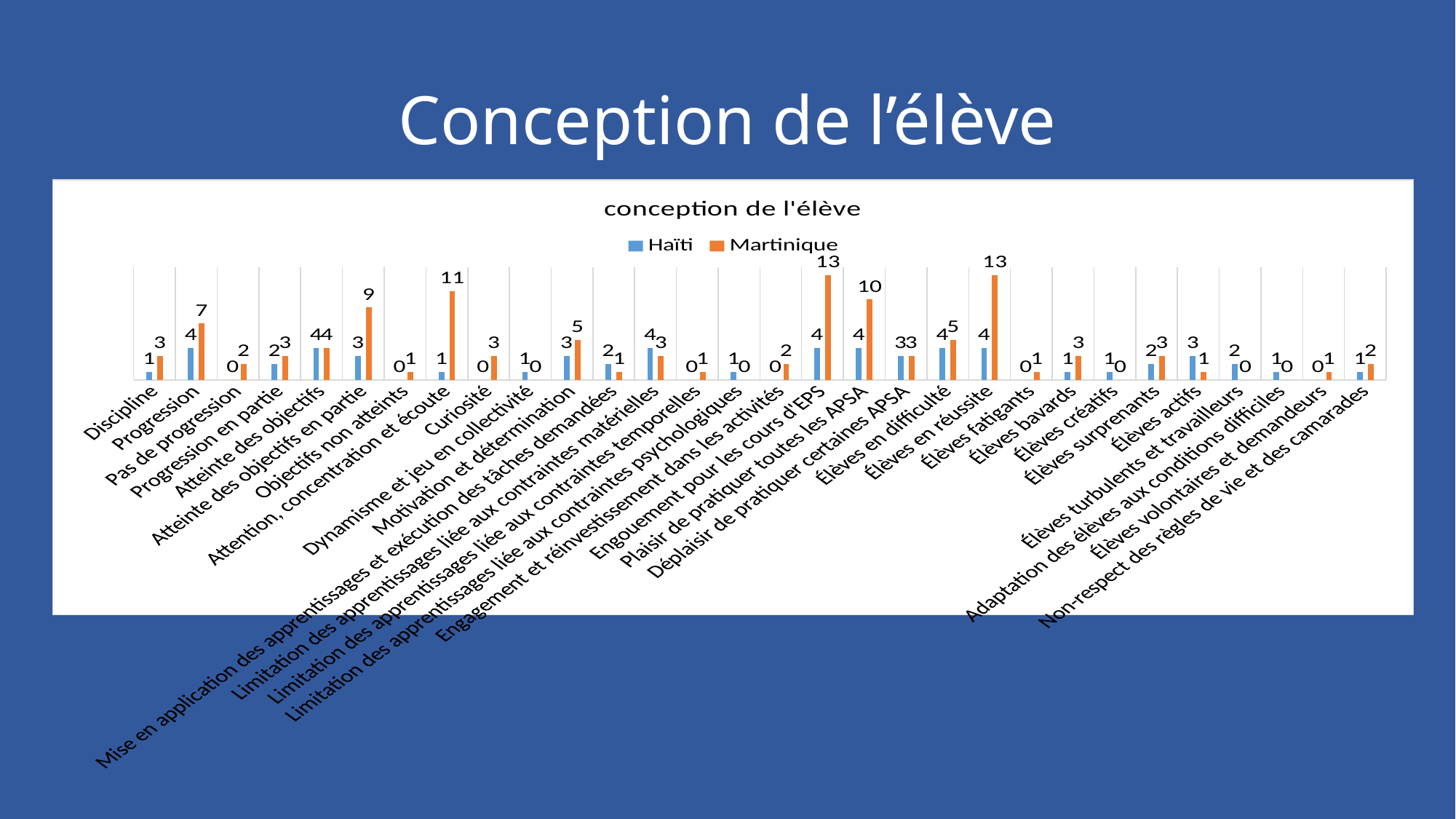
What is the Haïti value for "Progression"? 4 What kind of chart is shown on the slide? Bar chart What is the difference between the Martinique and Haïti values for "Engouement pour les cours d'EPS"? 9 What is the Haïti value for "Élèves actifs"? 3 For "Élèves actifs", which series has the larger value, Haïti or Martinique? Haïti What is the Martinique value for "Plaisir de pratiquer toutes les APSA"? 10 What is the Martinique value for "Attention, concentration et écoute"? 11 What is the difference between the Martinique and Haïti values for "Progression"? 3 For "Élèves en réussite", which series has the larger value, Haïti or Martinique? Martinique What is the title of the chart? conception de l'élève How many series does the legend list? 2 What is the Martinique value for "Atteinte des objectifs en partie"? 9